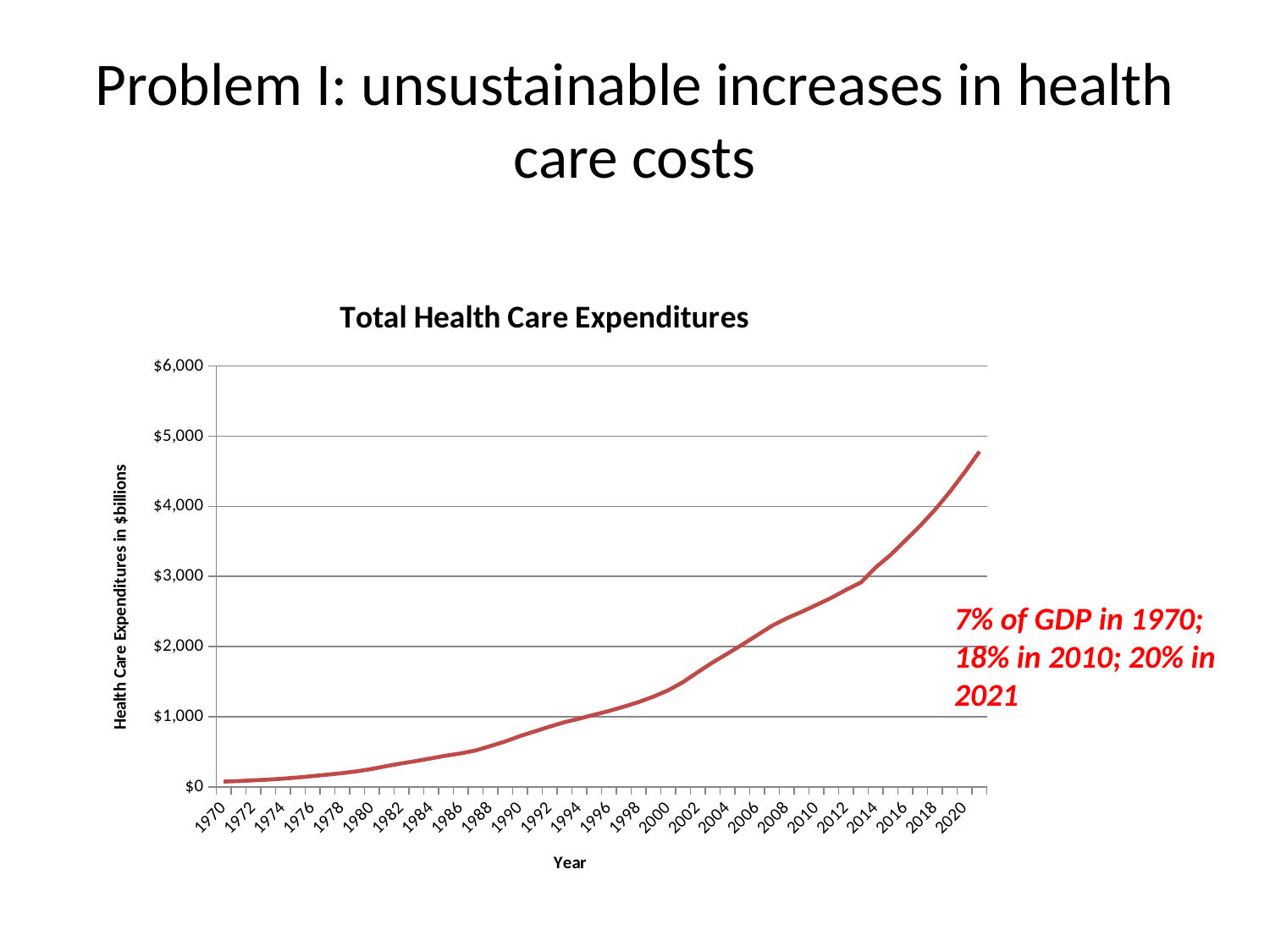
What is the label on the vertical axis of the chart? Health Care Expenditures in $billions Is the value for 2008 greater or less than $2,000? greater Is the value for 2002 greater or less than $2,000? less Is the value for 2016 greater or less than $3,000? greater What kind of chart is shown on the slide? line chart Which year shown has the lowest health care expenditures? 1970 Which year has higher health care expenditures, 1990 or 2010? 2010 Do health care expenditures rise or fall from 1970 to the end of the series? rise What is the title of the chart? Total Health Care Expenditures